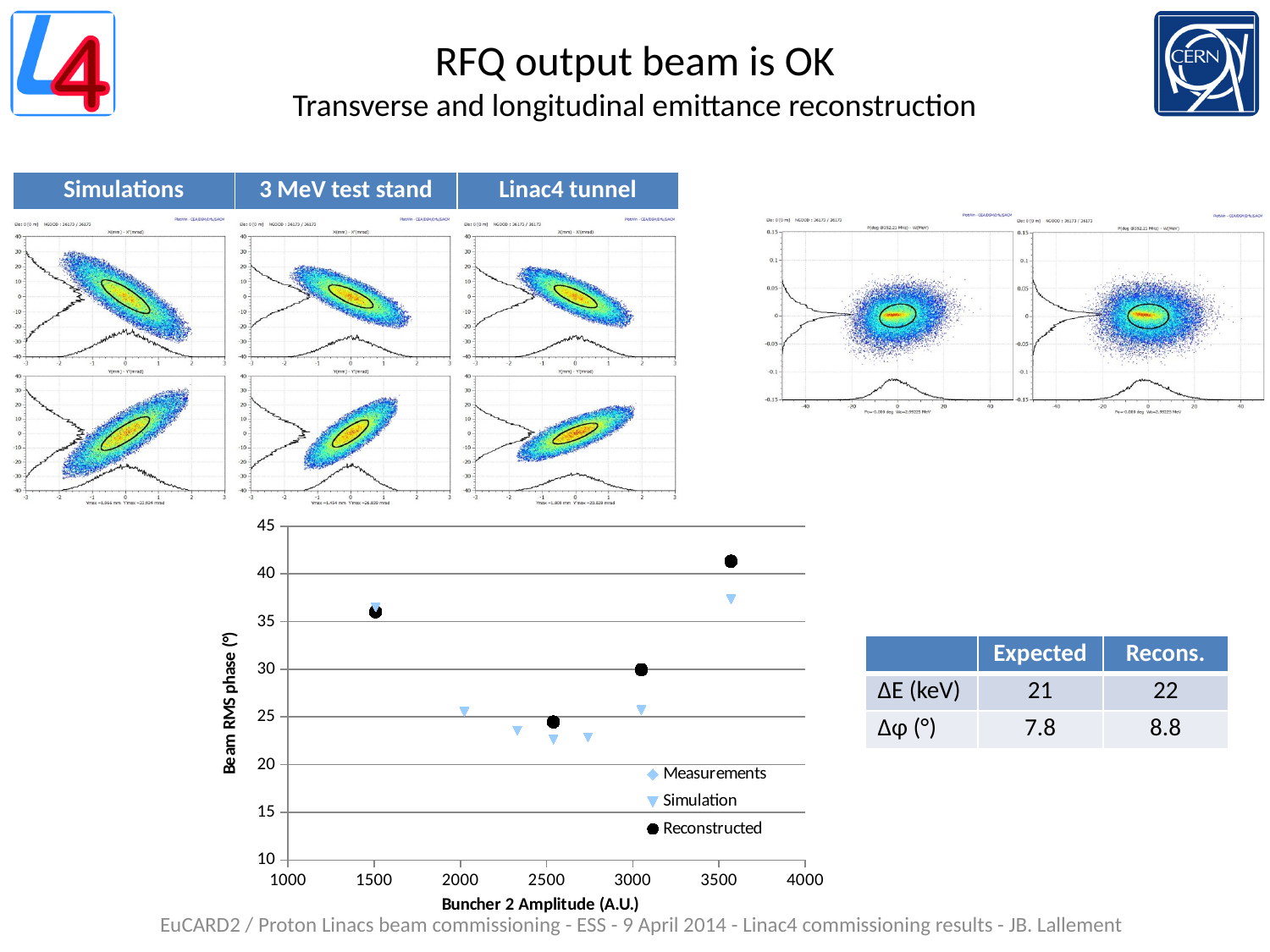
What is the y-axis title of the scatter chart at the bottom of the slide? Beam RMS phase (°) What is the x-axis title of the Beam RMS phase chart? Buncher 2 Amplitude (A.U.) In the Beam RMS phase chart, is the Reconstructed value at the highest Buncher 2 Amplitude (around 3550) greater or less than 40? greater In the Beam RMS phase chart, is the Reconstructed value at a Buncher 2 Amplitude of about 2550 greater or less than 30? less In the Beam RMS phase chart, at a Buncher 2 Amplitude of about 3550, which is larger: the Reconstructed value or the Simulation value? Reconstructed How many series does the legend of the Beam RMS phase chart list? 3 In the Beam RMS phase chart, how many Simulation (triangle) points are plotted? 7 In the Beam RMS phase chart, how many Reconstructed (black circle) points are plotted? 4 In the Beam RMS phase chart, is the Simulation value at the highest Buncher 2 Amplitude (around 3550) greater or less than 40? less What kind of chart is the plot of Beam RMS phase against Buncher 2 Amplitude? scatter chart